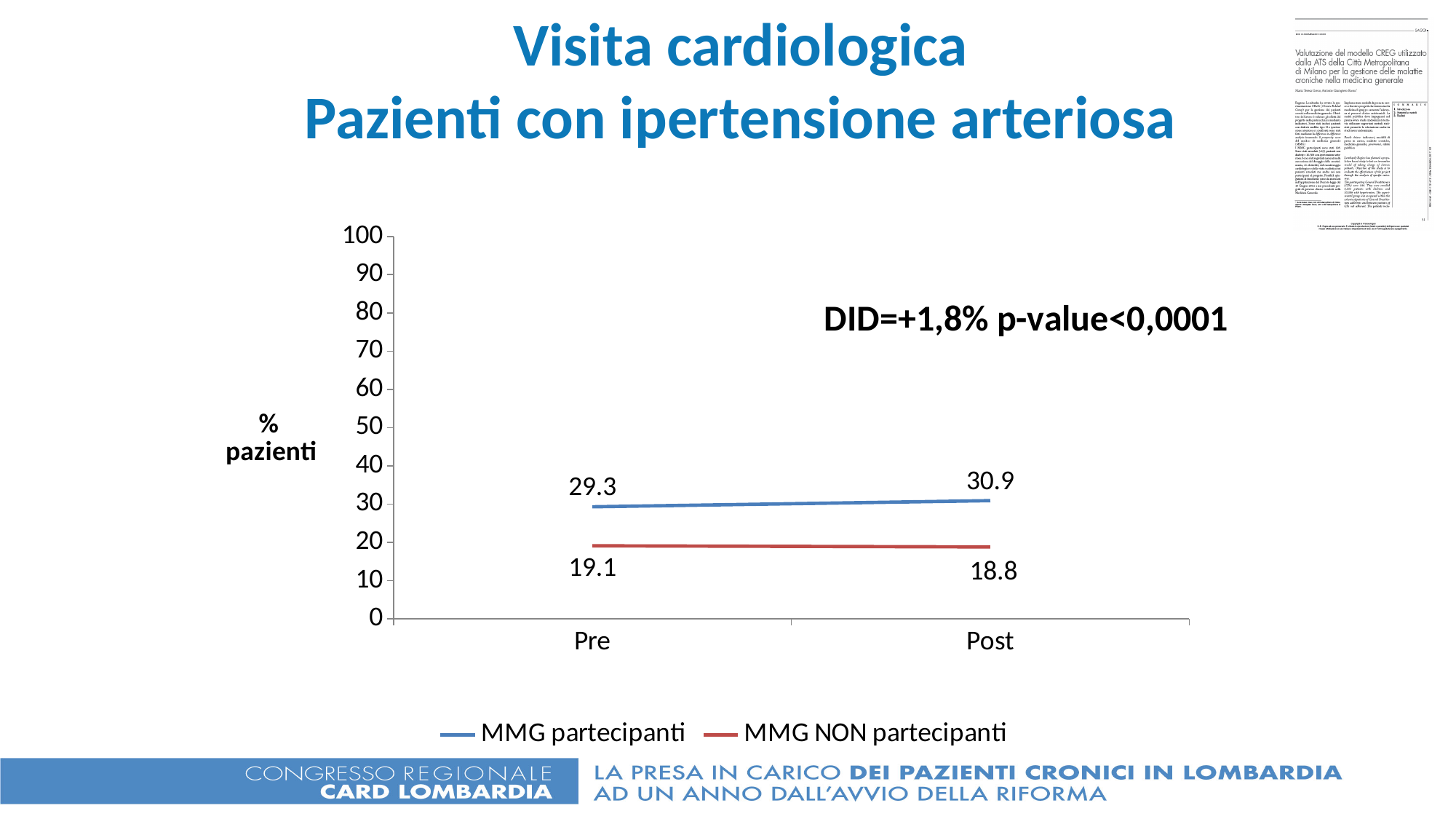
What is the value for MMG NON partecipanti at Post? 18.8 Which series has the higher value at Pre, MMG partecipanti or MMG NON partecipanti? MMG partecipanti What kind of chart is shown on the slide? line chart What is the difference between the MMG partecipanti values at Post and Pre? 1.6 What DID value and p-value are printed on the chart? DID=+1,8% p-value<0,0001 How many series does the legend list? 2 What is the value for MMG NON partecipanti at Pre? 19.1 Does the MMG partecipanti line rise or fall from Pre to Post? rise What is the value for MMG partecipanti at Pre? 29.3 What is the value for MMG partecipanti at Post? 30.9 Does the MMG NON partecipanti line rise or fall from Pre to Post? fall What is the difference between MMG partecipanti and MMG NON partecipanti at Post? 12.1